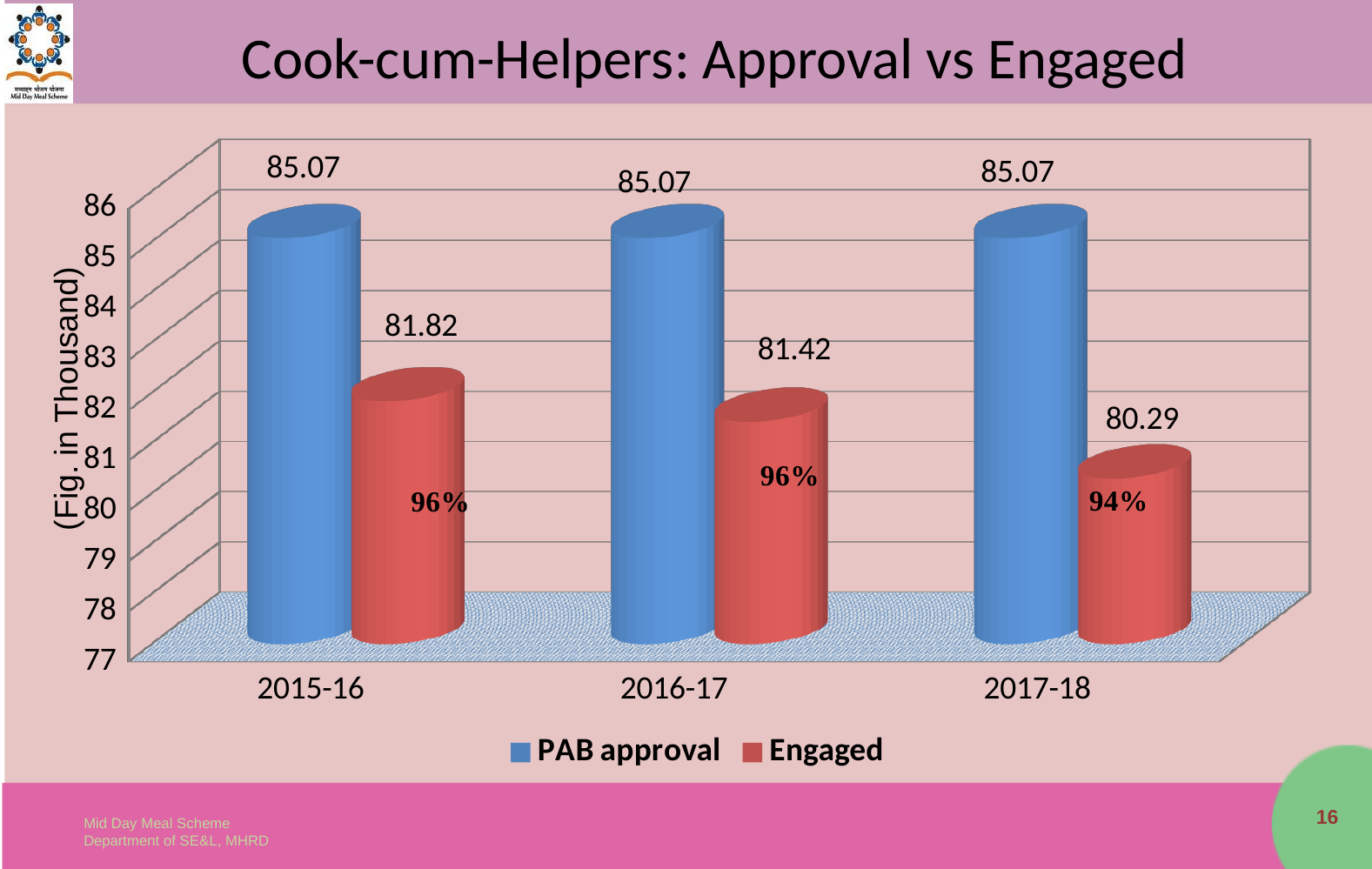
Which year has the highest Engaged value? 2015-16 How many years are shown on the x axis? 3 What is the difference between PAB approval and Engaged in 2017-18? 4.78 What is the PAB approval value for 2015-16? 85.07 What is the Engaged value for 2016-17? 81.42 Which year has the lowest Engaged value? 2017-18 What is the difference between the Engaged values for 2015-16 and 2016-17? 0.4 Which is larger in 2016-17, PAB approval or Engaged? PAB approval Do the Engaged values rise or fall from 2015-16 to 2017-18? Fall What is the Engaged value for 2017-18? 80.29 How many series does the legend list? 2 What kind of chart is shown on the slide? Bar chart